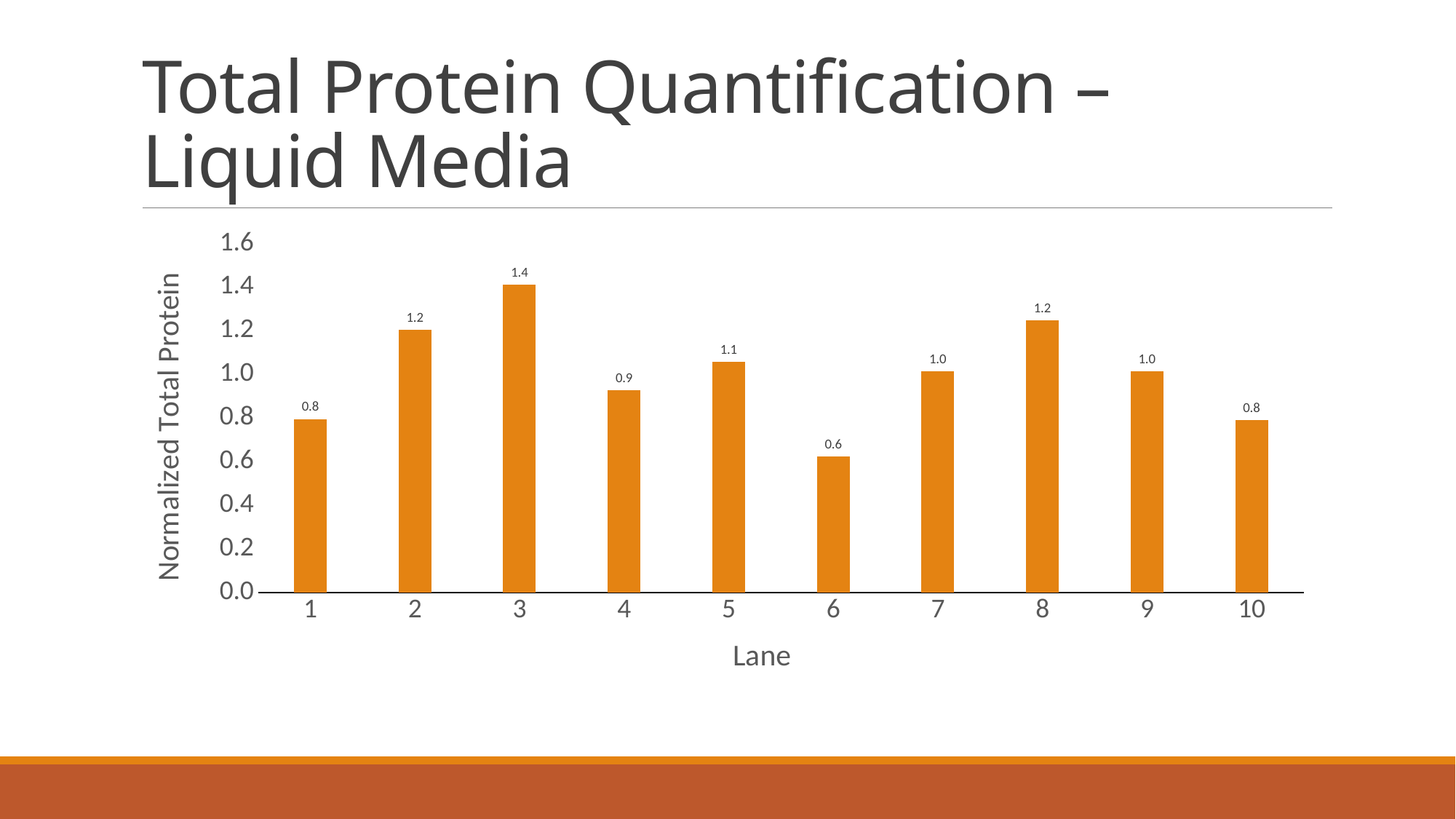
Which lane has the highest normalized total protein? 3 What is the label of the y axis? Normalized Total Protein What is the label of the x axis? Lane What is the normalized total protein value for lane 6? 0.6 How many lanes are shown on the x axis? 10 What is the difference between the normalized total protein values for lane 3 and lane 6? 0.8 Which lane has the lowest normalized total protein? 6 What is the normalized total protein value for lane 3? 1.4 What is the normalized total protein value for lane 8? 1.2 What kind of chart is shown on the slide? Bar chart Is the value for lane 5 greater or less than 1.0? greater Which has a larger normalized total protein value, lane 2 or lane 4? Lane 2